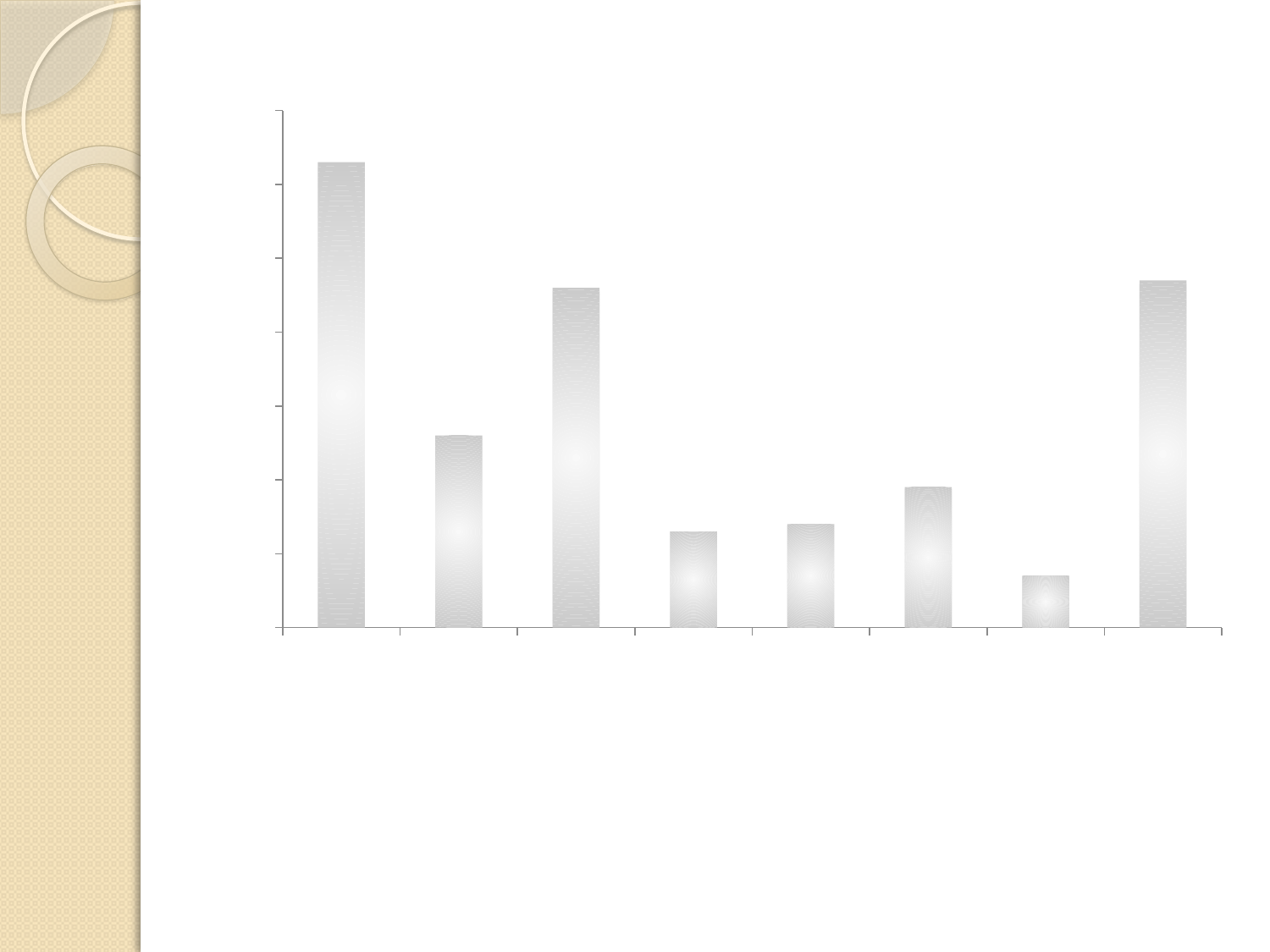
Which is taller in the chart, the second bar from the left or the third bar from the left? the third bar Which is taller in the chart, the first bar from the left or the last bar on the right? the first bar What kind of chart is shown on the slide? bar chart Does the chart have a title shown on the slide? No Does the chart display a legend? No Which bar in the chart is the tallest, counting from the left? the first bar How many bars are plotted in the chart? 8 Which bar in the chart is the shortest, counting from the left? the seventh bar